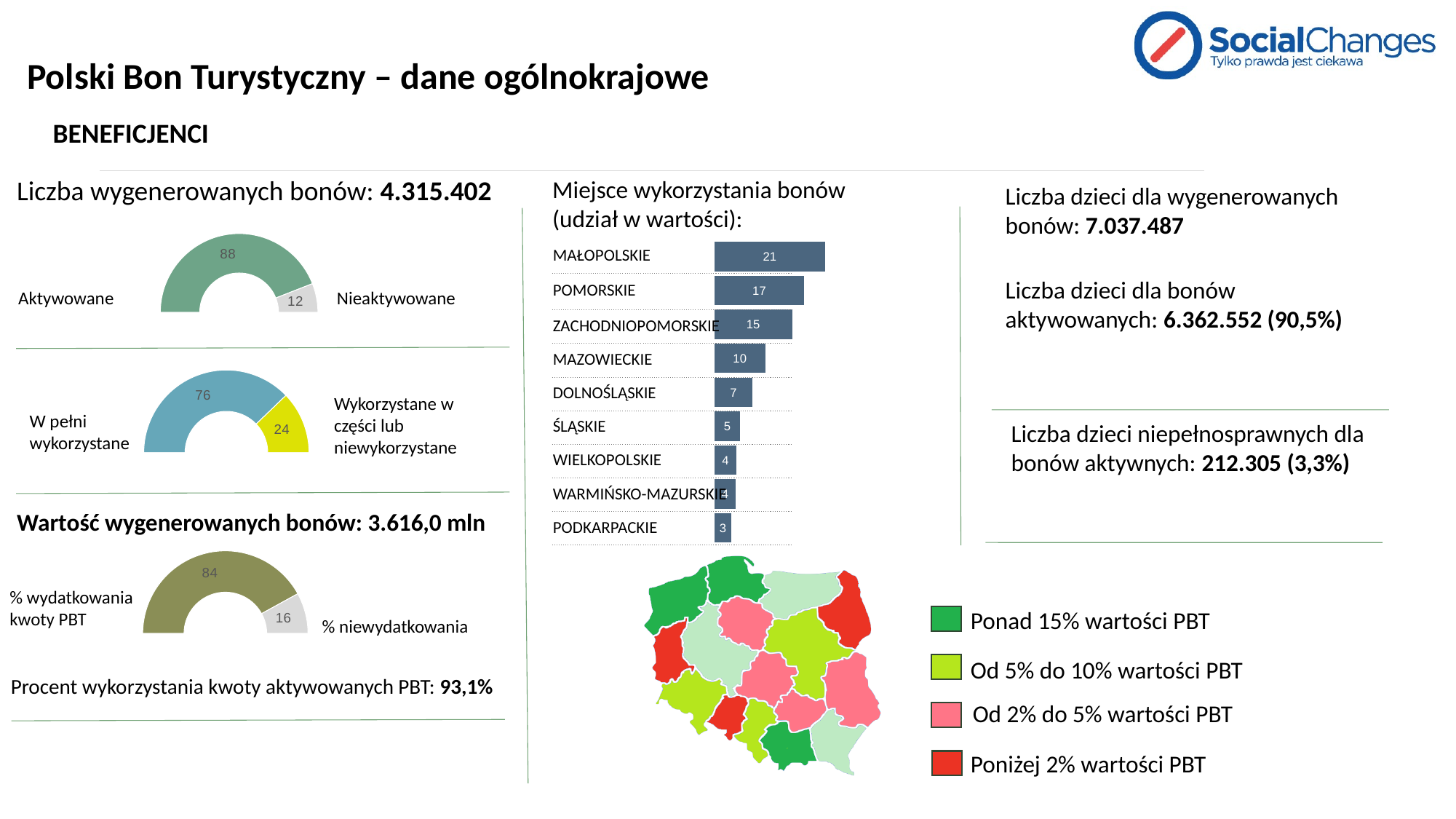
In the map legend, what does the darkest green colour represent? Ponad 15% wartości PBT In the middle-left half-donut chart, what is the value for 'Wykorzystane w części lub niewykorzystane'? 24 In the bar chart 'Miejsce wykorzystania bonów (udział w wartości)', which has a larger value, DOLNOŚLĄSKIE or ŚLĄSKIE? DOLNOŚLĄSKIE In the bottom-left half-donut chart under 'Wartość wygenerowanych bonów', what is the value for '% niewydatkowania'? 16 In the top-left half-donut chart under 'Liczba wygenerowanych bonów', what is the value for Aktywowane? 88 In the bar chart 'Miejsce wykorzystania bonów (udział w wartości)', which region has the lowest value? PODKARPACKIE In the bar chart 'Miejsce wykorzystania bonów (udział w wartości)', what is the value for MAZOWIECKIE? 10 In the bar chart 'Miejsce wykorzystania bonów (udział w wartości)', what is the difference between the values for POMORSKIE and ZACHODNIOPOMORSKIE? 2 What kind of chart is 'Miejsce wykorzystania bonów (udział w wartości)'? bar chart How many regions are listed in the bar chart 'Miejsce wykorzystania bonów (udział w wartości)'? 9 In the bar chart 'Miejsce wykorzystania bonów (udział w wartości)', what is the value for MAŁOPOLSKIE? 21 In the bar chart 'Miejsce wykorzystania bonów (udział w wartości)', which region has the highest value? MAŁOPOLSKIE